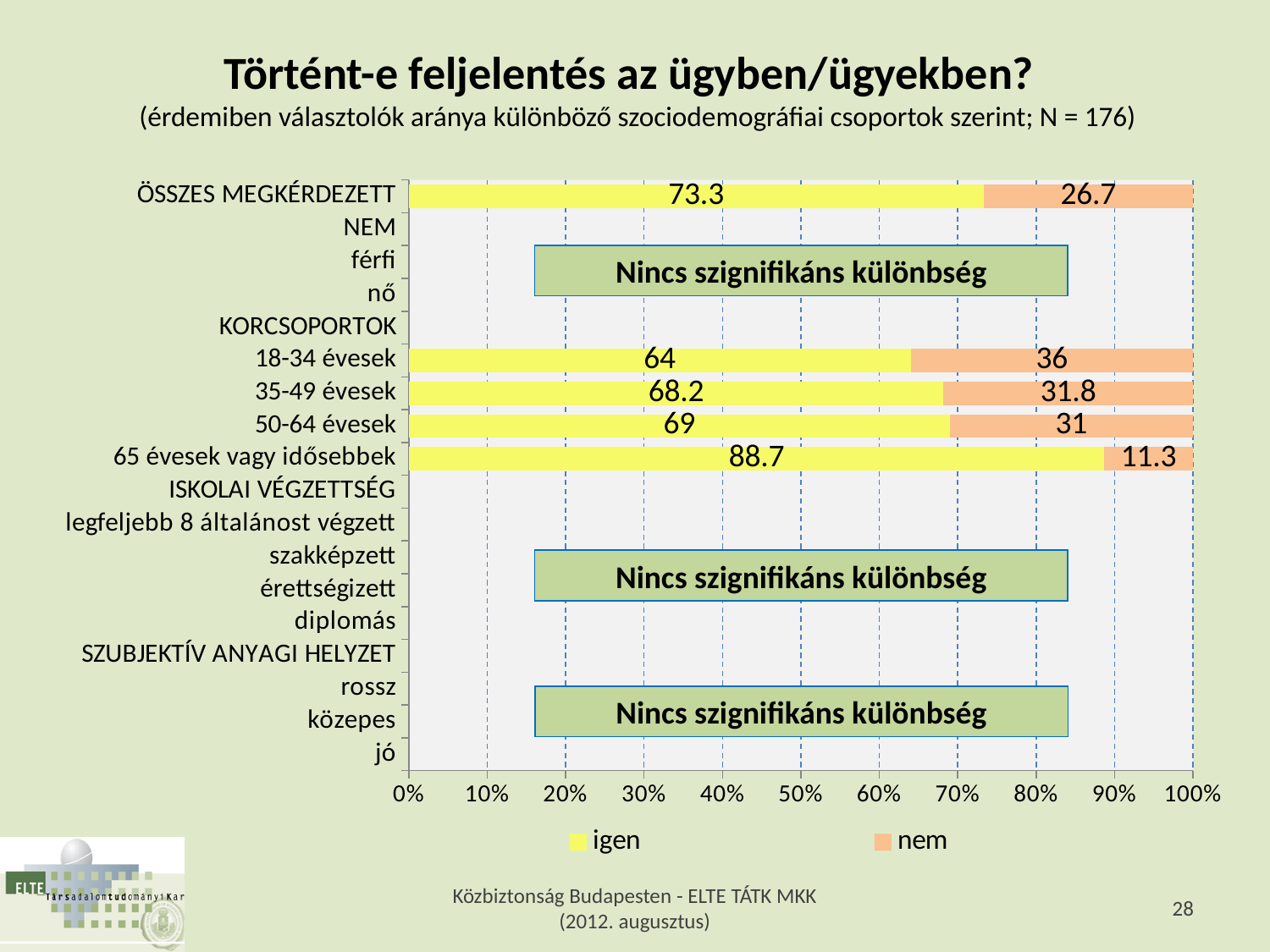
Among the age groups shown with bars, which has the lowest 'igen' value? 18-34 évesek Among the age groups shown with bars, which has the highest 'igen' value? 65 évesek vagy idősebbek What kind of chart is shown on the slide? Stacked bar chart Which is larger: the 'nem' value for 50-64 évesek or for 35-49 évesek? 35-49 évesek How many series does the legend list? 2 What is the 'igen' value for ÖSSZES MEGKÉRDEZETT? 73.3 What is the 'igen' value for 35-49 évesek? 68.2 What is the difference between the 'igen' values for 65 évesek vagy idősebbek and 18-34 évesek? 24.7 What is the 'nem' value for 65 évesek vagy idősebbek? 11.3 What is the total of the stacked bar for 50-64 évesek? 100 What text appears in the green boxes placed over the NEM, ISKOLAI VÉGZETTSÉG and SZUBJEKTÍV ANYAGI HELYZET groups? Nincs szignifikáns különbség What is the 'nem' value for 18-34 évesek? 36